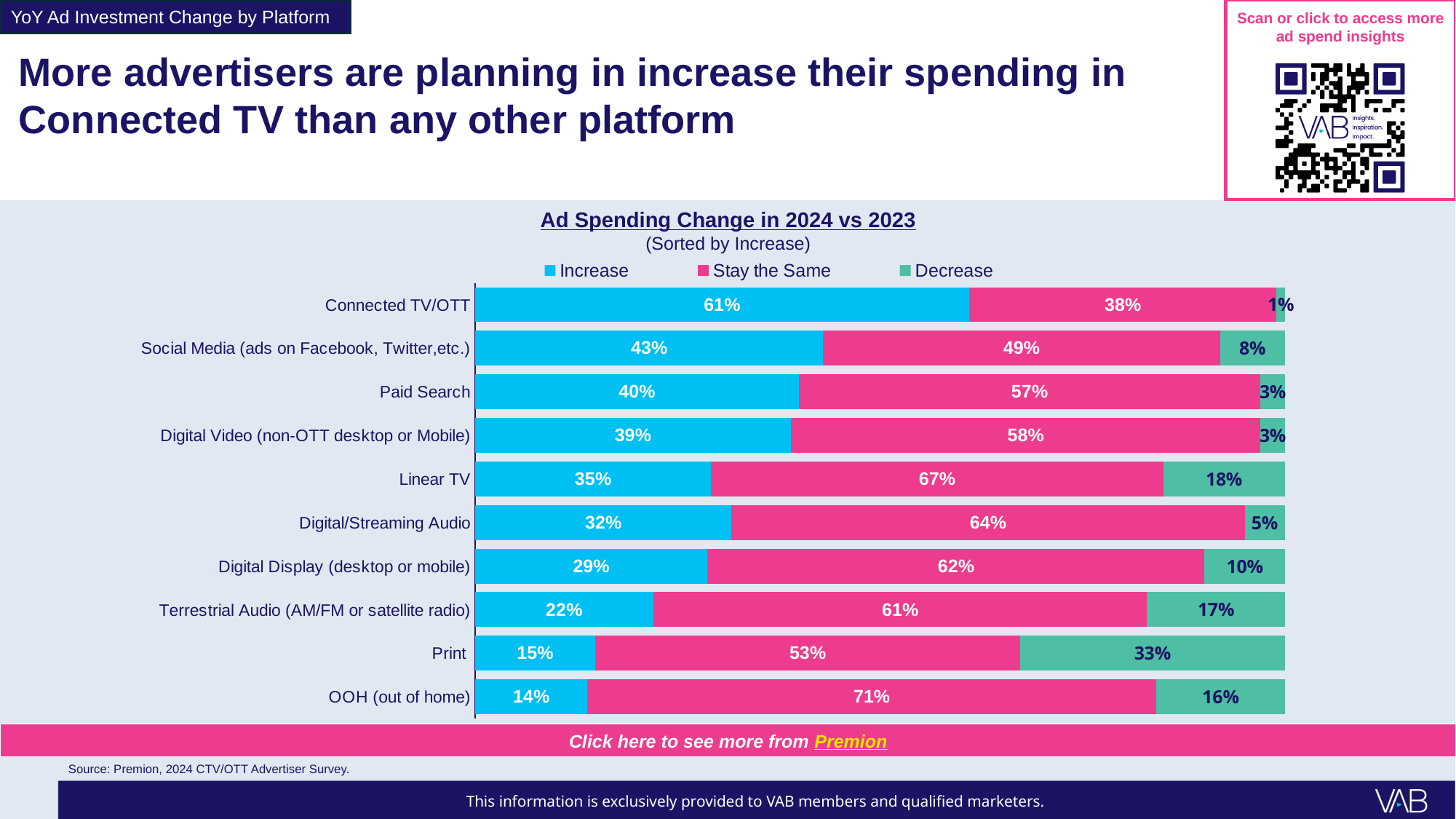
What percentage of advertisers plan to increase spending on Connected TV/OTT? 61% Which has a larger 'Decrease' value, Linear TV or Terrestrial Audio (AM/FM or satellite radio)? Linear TV Which platform has the highest 'Decrease' value? Print What is the difference between the 'Increase' values for Connected TV/OTT and Social Media? 18% Which platform has the highest 'Increase' value? Connected TV/OTT How many series does the legend list? 3 What is the title of the chart? Ad Spending Change in 2024 vs 2023 How many platforms are shown in the chart? 10 What is the 'Stay the Same' value for OOH (out of home)? 71% Which platform has the lowest 'Increase' value? OOH (out of home) What type of chart is shown on the slide? Stacked bar chart What is the 'Decrease' value for Print? 33%